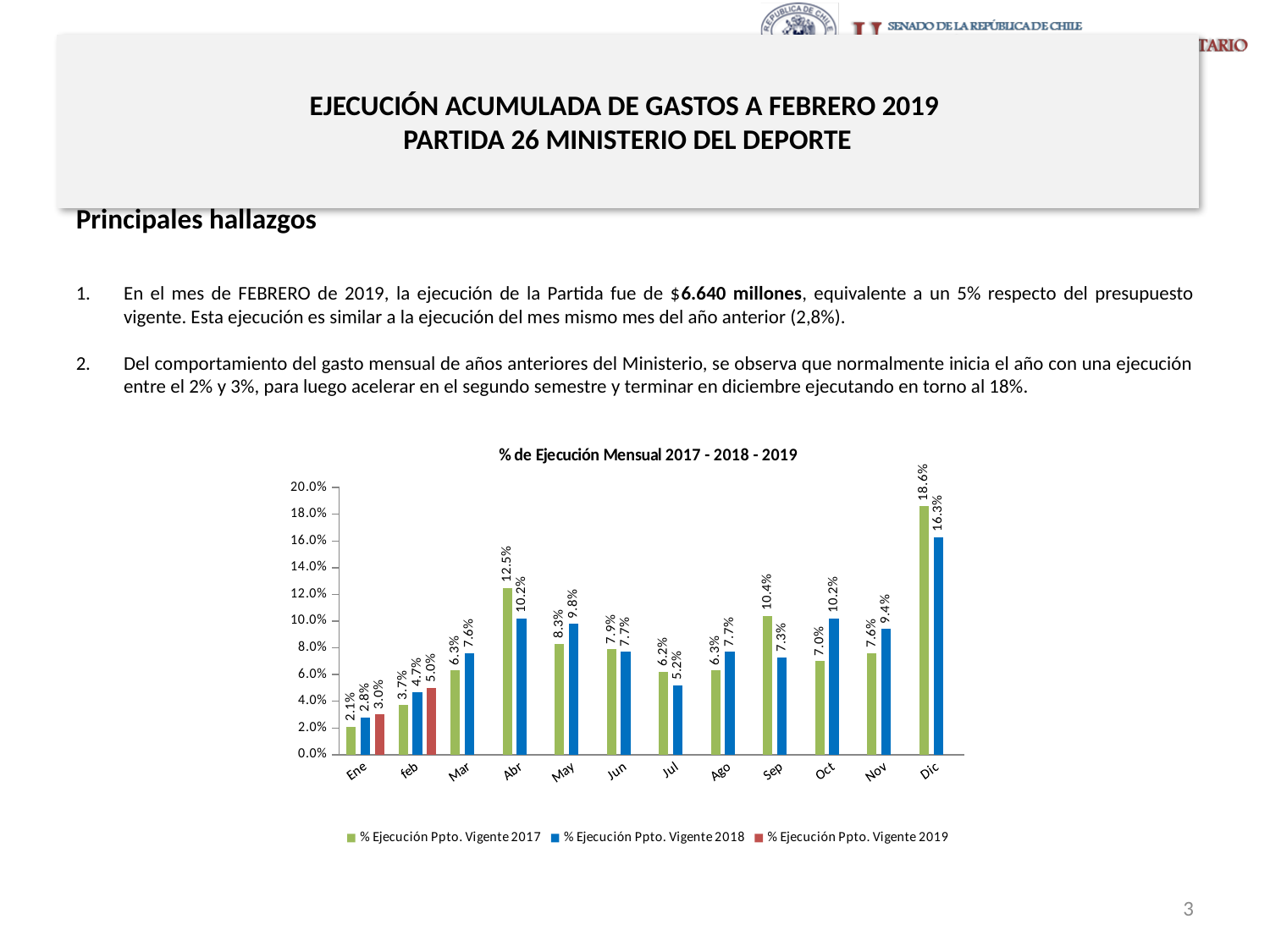
Which month has the lowest value for % Ejecución Ppto. Vigente 2018? Ene What is the difference between the 2017 and 2018 values in Sep? 3.1% Which month has the highest value for % Ejecución Ppto. Vigente 2017? Dic In Oct, which series has the larger value, 2017 or 2018? 2018 Is the value for % Ejecución Ppto. Vigente 2017 in Dic greater or less than 18.0%? greater What is the title of the chart? % de Ejecución Mensual 2017 - 2018 - 2019 How many series does the chart legend list? 3 What is the value for % Ejecución Ppto. Vigente 2018 in Dic? 16.3% What is the value for % Ejecución Ppto. Vigente 2019 in feb? 5.0% What is the value for % Ejecución Ppto. Vigente 2017 in Abr? 12.5% What type of chart is shown on the slide? bar chart How many months are shown on the x axis of the chart? 12